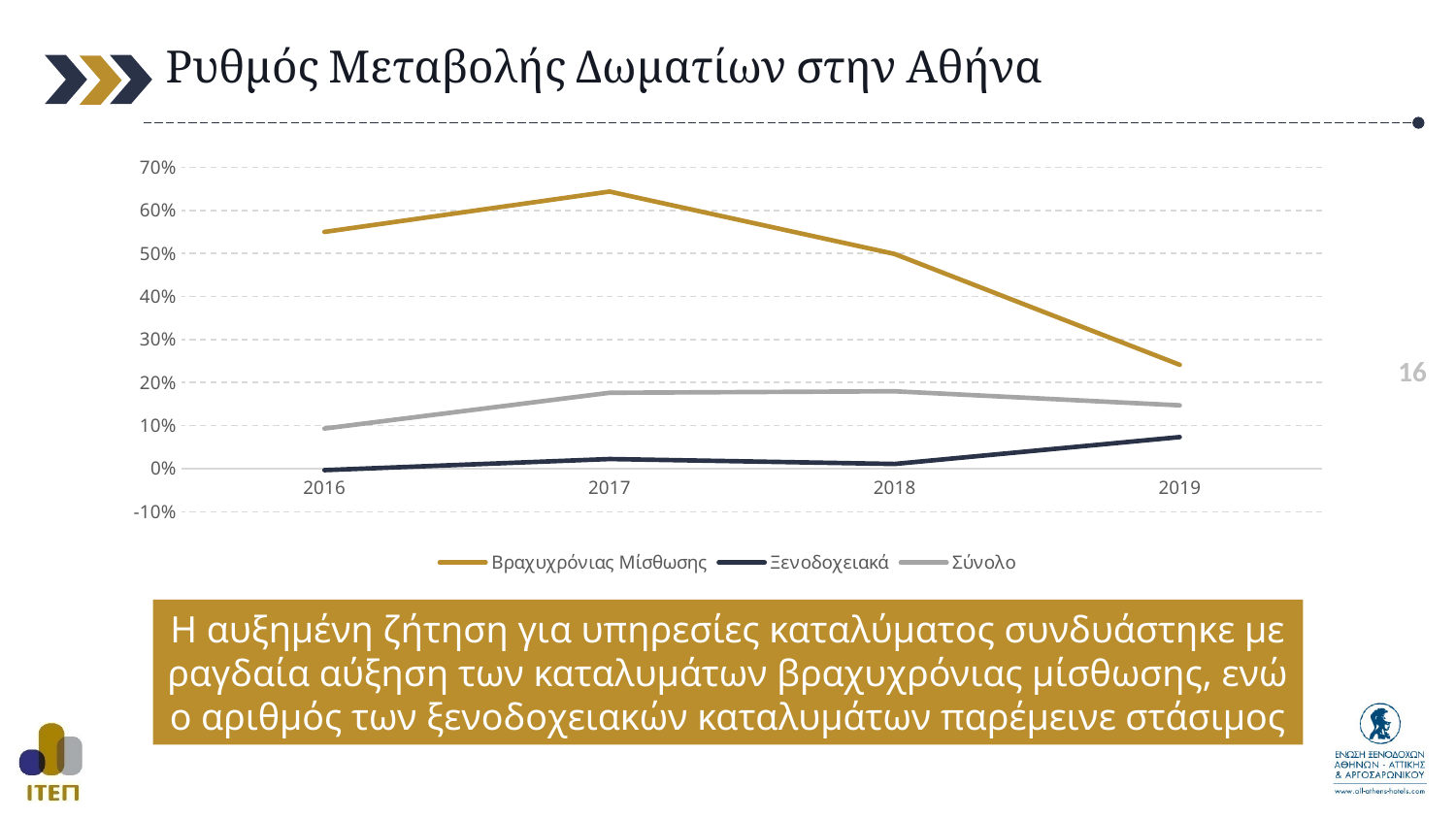
In 2018, which series has the larger value, Βραχυχρόνιας Μίσθωσης or Σύνολο? Βραχυχρόνιας Μίσθωσης Does the Βραχυχρόνιας Μίσθωσης line rise or fall from 2017 to 2019? fall In which year does the Βραχυχρόνιας Μίσθωσης line reach its lowest value? 2019 In which year does the Βραχυχρόνιας Μίσθωσης line reach its highest value? 2017 How many series does the legend list? 3 Is the value for Ξενοδοχειακά in 2019 greater or less than 10%? less Is the value for Σύνολο in 2017 greater or less than 10%? greater Is the value for Βραχυχρόνιας Μίσθωσης in 2019 greater or less than 30%? less What kind of chart is shown on the slide? line chart What is the title of the slide containing the chart? Ρυθμός Μεταβολής Δωματίων στην Αθήνα How many years are shown on the x axis? 4